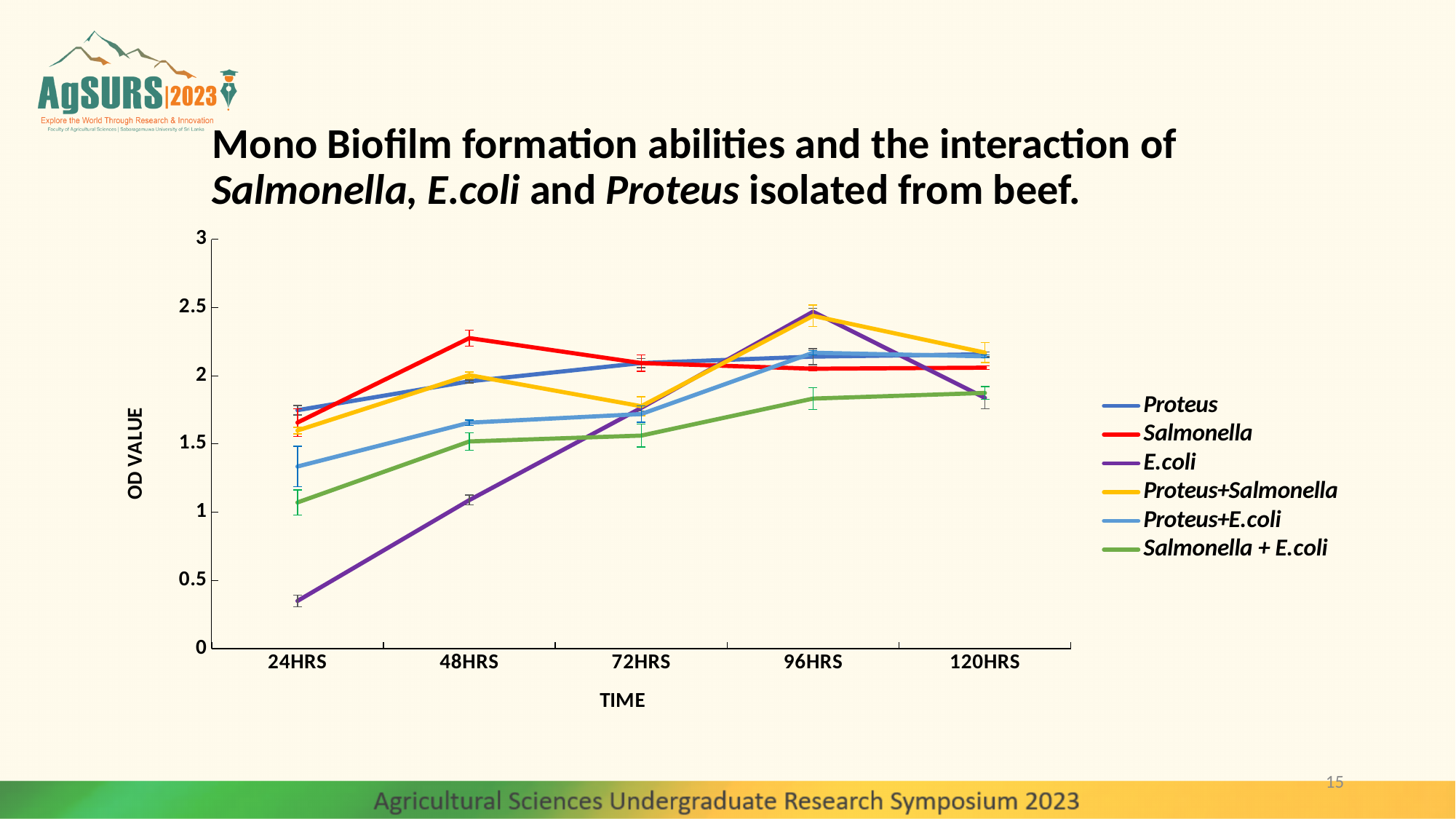
How many series does the legend list? 6 Which series has the lowest OD value at 24HRS? E.coli At 48HRS, which is larger: the OD value for Proteus+Salmonella or for Proteus+E.coli? Proteus+Salmonella Is the OD value for Salmonella at 48HRS greater or less than 2? greater Which series has the highest OD value at 48HRS? Salmonella What is the label on the y axis of the chart? OD VALUE Which series has the lowest OD value at 48HRS? E.coli Is the OD value for Proteus+E.coli at 24HRS greater or less than 1.5? less How many time points are plotted along the x axis? 5 Is the OD value for E.coli at 24HRS greater or less than 0.5? less What kind of chart is shown on the slide? line chart Does the OD value for E.coli rise or fall from 24HRS to 96HRS? rise